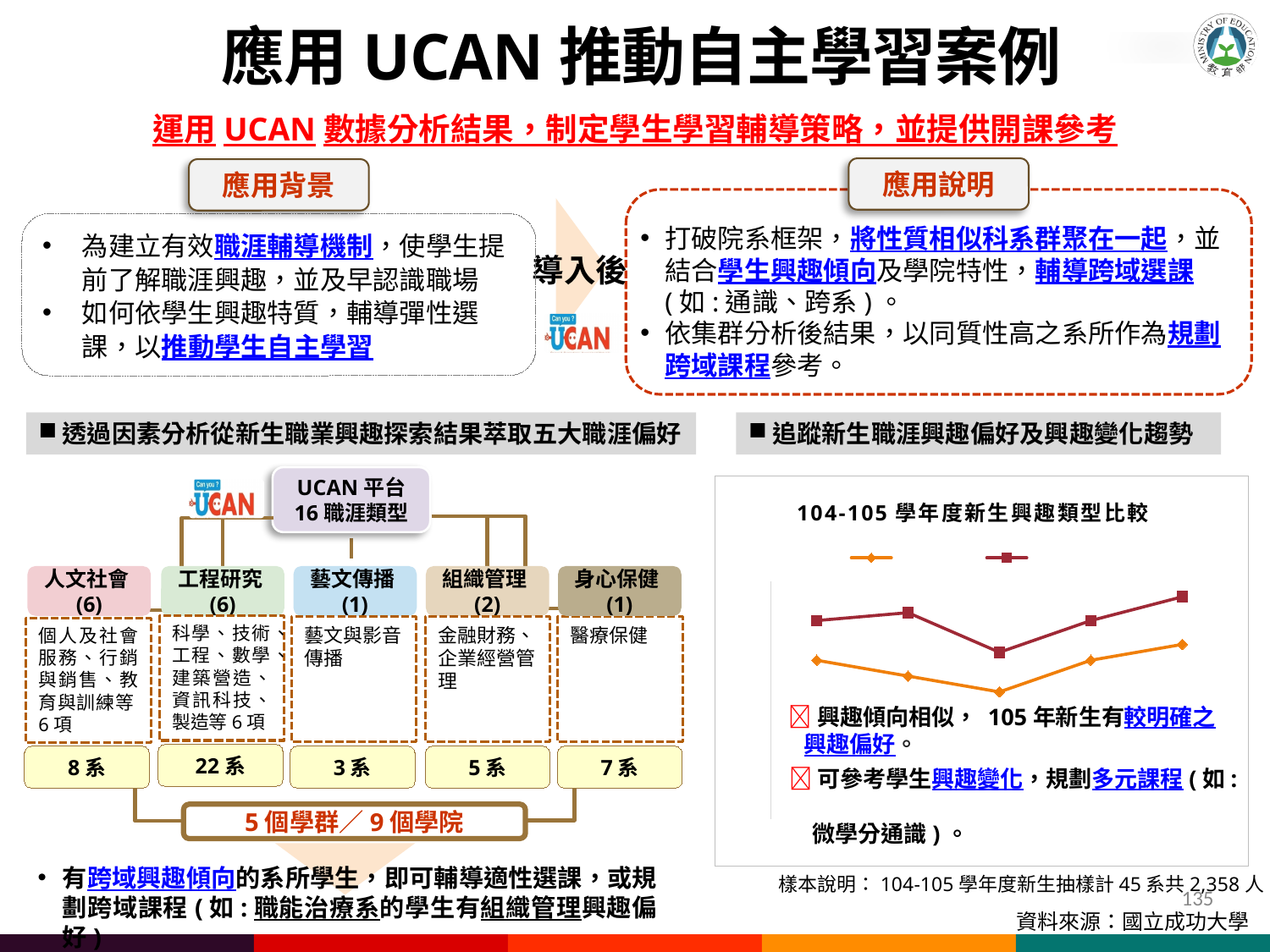
In the chart 104-105 學年度新生興趣類型比較, which point of the orange line is the lowest? The third point In the chart 104-105 學年度新生興趣類型比較, do the lines rise or fall from the third point to the fifth point? Rise What kind of chart is shown under the heading 追蹤新生職涯興趣偏好及興趣變化趨勢? Line chart In the chart 104-105 學年度新生興趣類型比較, is the dark red line above or below the orange line? Above In the chart 104-105 學年度新生興趣類型比較, which point of the dark red line is the highest? The fifth point What is the title of the line chart on the right side of the slide? 104-105 學年度新生興趣類型比較 How many series does the legend of the chart 104-105 學年度新生興趣類型比較 show? 2 What colours are the two lines in the chart 104-105 學年度新生興趣類型比較? Orange and dark red How many data points does each line in the chart 104-105 學年度新生興趣類型比較 have? 5 In the chart 104-105 學年度新生興趣類型比較, does the orange line rise or fall from the first point to the third point? Fall